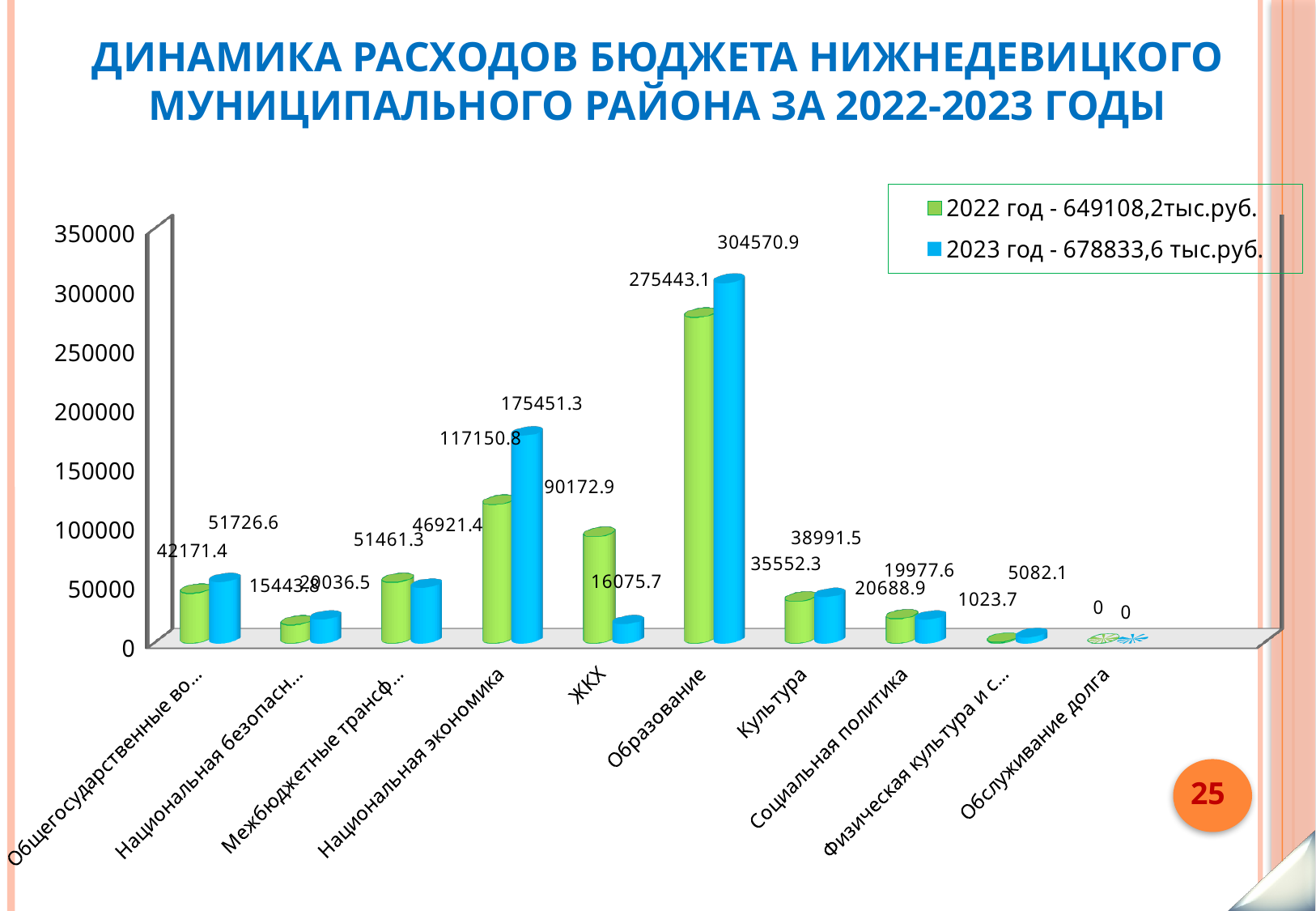
How many categories are shown on the x axis? 10 What is the 2022 value for ЖКХ? 90172.9 What is the 2023 value for Национальная экономика? 175451.3 What type of chart is shown on the slide? Bar chart For ЖКХ, which year has the larger value, 2022 or 2023? 2022 What is the 2023 value for Образование? 304570.9 What total is given in the legend for 2023 год? 678833,6 тыс.руб. Which category has the lowest 2022 value? Обслуживание долга What is the difference between the 2023 and 2022 values for Образование? 29127.8 How many series does the legend list? 2 Which category has the highest 2023 value? Образование What is the 2022 value for Социальная политика? 20688.9